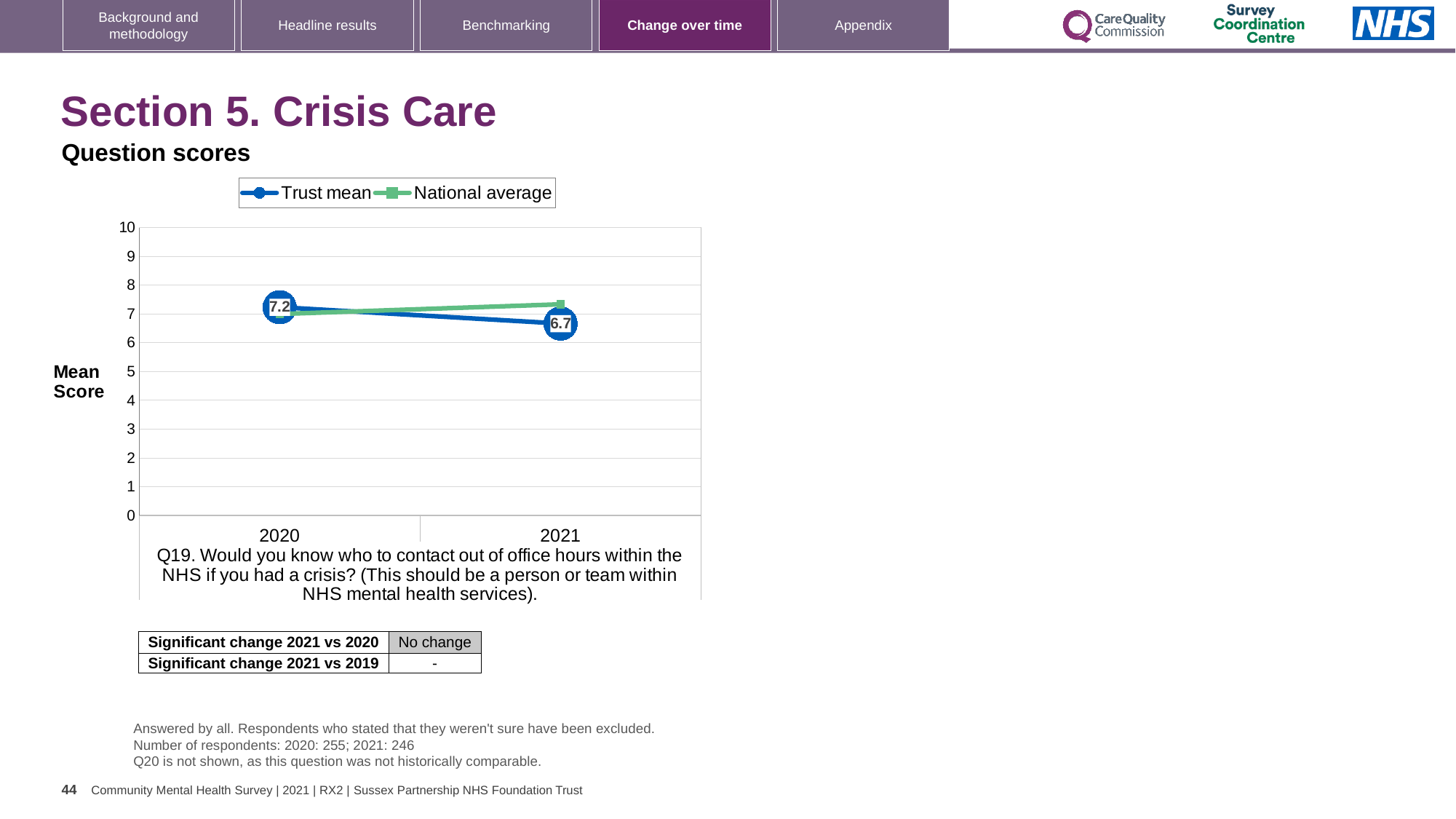
Which year has the higher Trust mean score, 2020 or 2021? 2020 Is the National average value for 2021 greater or less than 8? less In 2021, which series has the higher value, Trust mean or National average? National average What kind of chart is shown on the slide? line chart How many series does the chart legend list? 2 How many years are plotted on the x axis of the chart? 2 Does the Trust mean rise or fall from 2020 to 2021? fall By how much did the Trust mean score change from 2020 to 2021? 0.5 What is the Trust mean score for 2021? 6.7 What is the Trust mean score for 2020? 7.2 What is the label on the y axis of the chart? Mean Score Is the National average value for 2021 greater or less than 7? greater